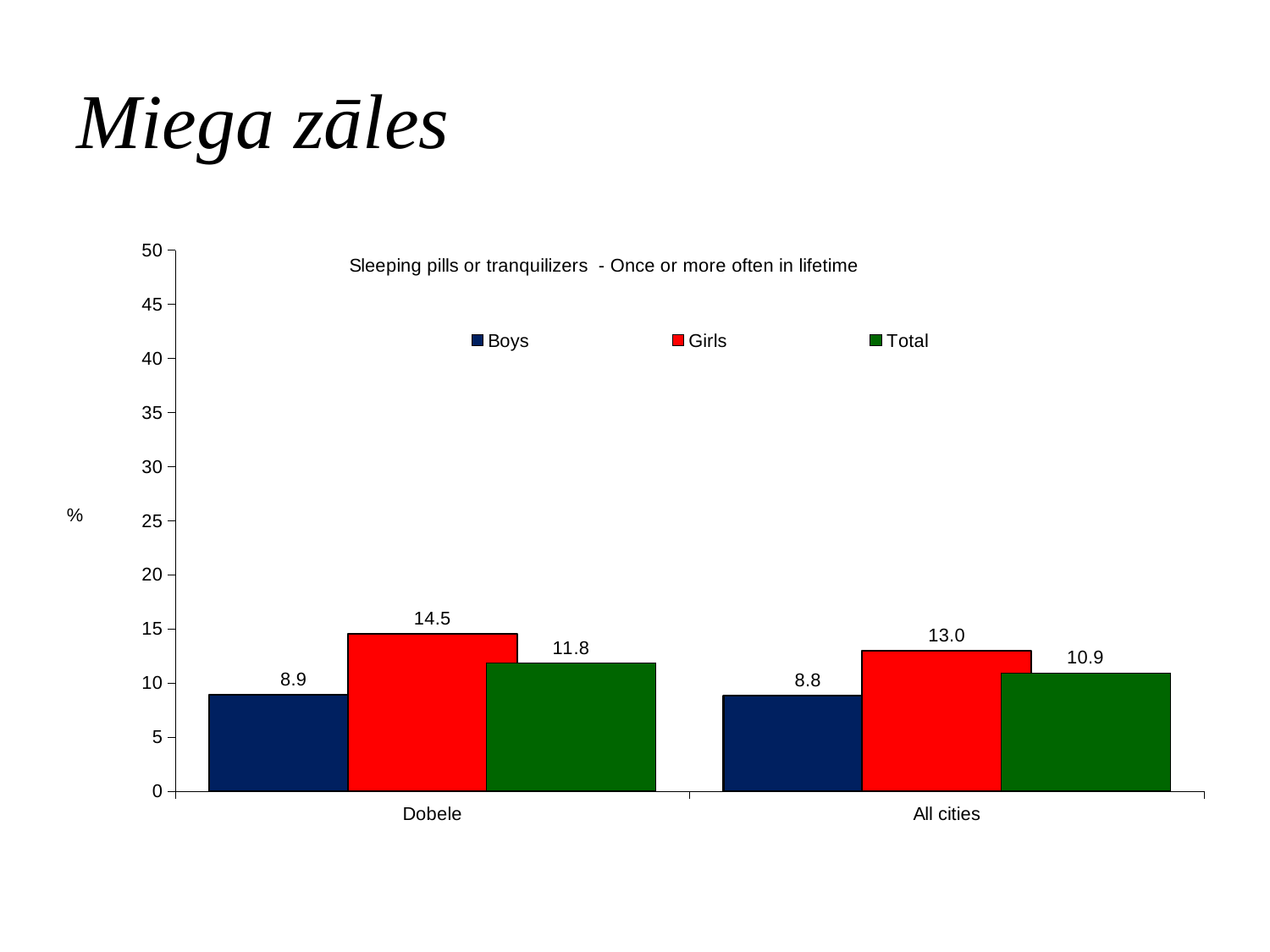
What is the difference between the Girls value in Dobele and the Girls value in All cities? 1.5 Which is larger, the Total value for Dobele or the Total value for All cities? Dobele What is the value for Total in Dobele? 11.8 What is the title of the chart? Sleeping pills or tranquilizers - Once or more often in lifetime How many categories are shown on the x axis? 2 What is the value for Girls in Dobele? 14.5 How many series does the legend list? 3 Is the value for Girls in Dobele greater or less than 10? greater Which series has the highest value in All cities? Girls Which series has the lowest value in Dobele? Boys What kind of chart is shown on the slide? bar chart What is the value for Boys in All cities? 8.8